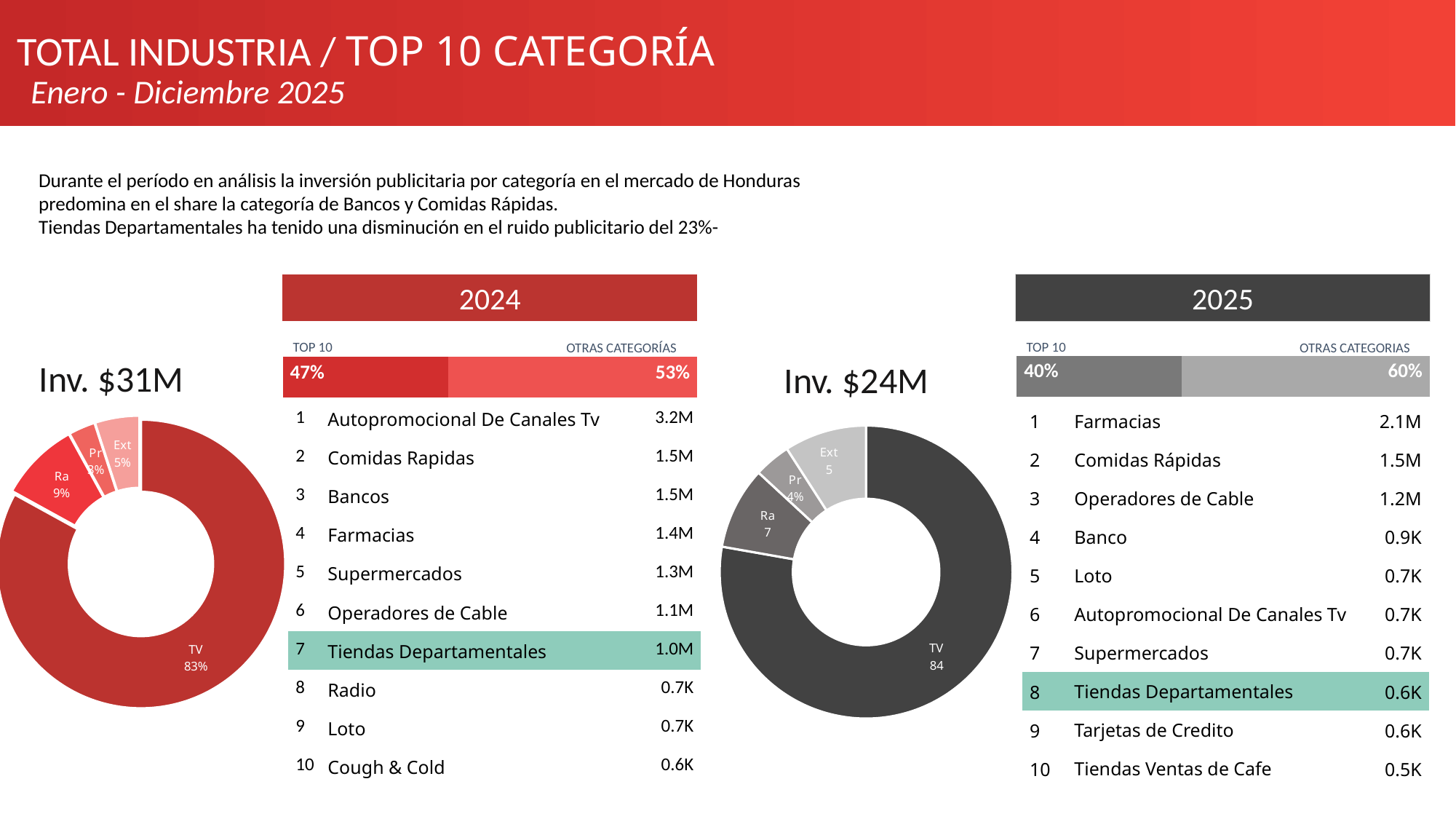
In the 2025 donut chart (right), which is larger, Ra or Pr? Ra In the 2024 donut chart (left), what is the difference between the TV share and the Ra share? 74% In the 2025 donut chart (right), what value is shown for Ra? 7 In the 2024 donut chart (left), which segment is the largest? TV In the 2025 stacked bar, what share is shown for OTRAS CATEGORIAS? 60% In the 2025 donut chart (right), what value is shown for TV? 84 What kind of chart is shown under "Inv. $31M" on the left of the slide? Donut chart How many segments does the 2024 donut chart (left) have? 4 In the 2024 stacked bar, what share is shown for TOP 10? 47% In the 2024 donut chart (left), which segment is the smallest? Pr In the 2024 donut chart (left), what share does TV have? 83% In the 2024 donut chart (left), what share does Ra have? 9%